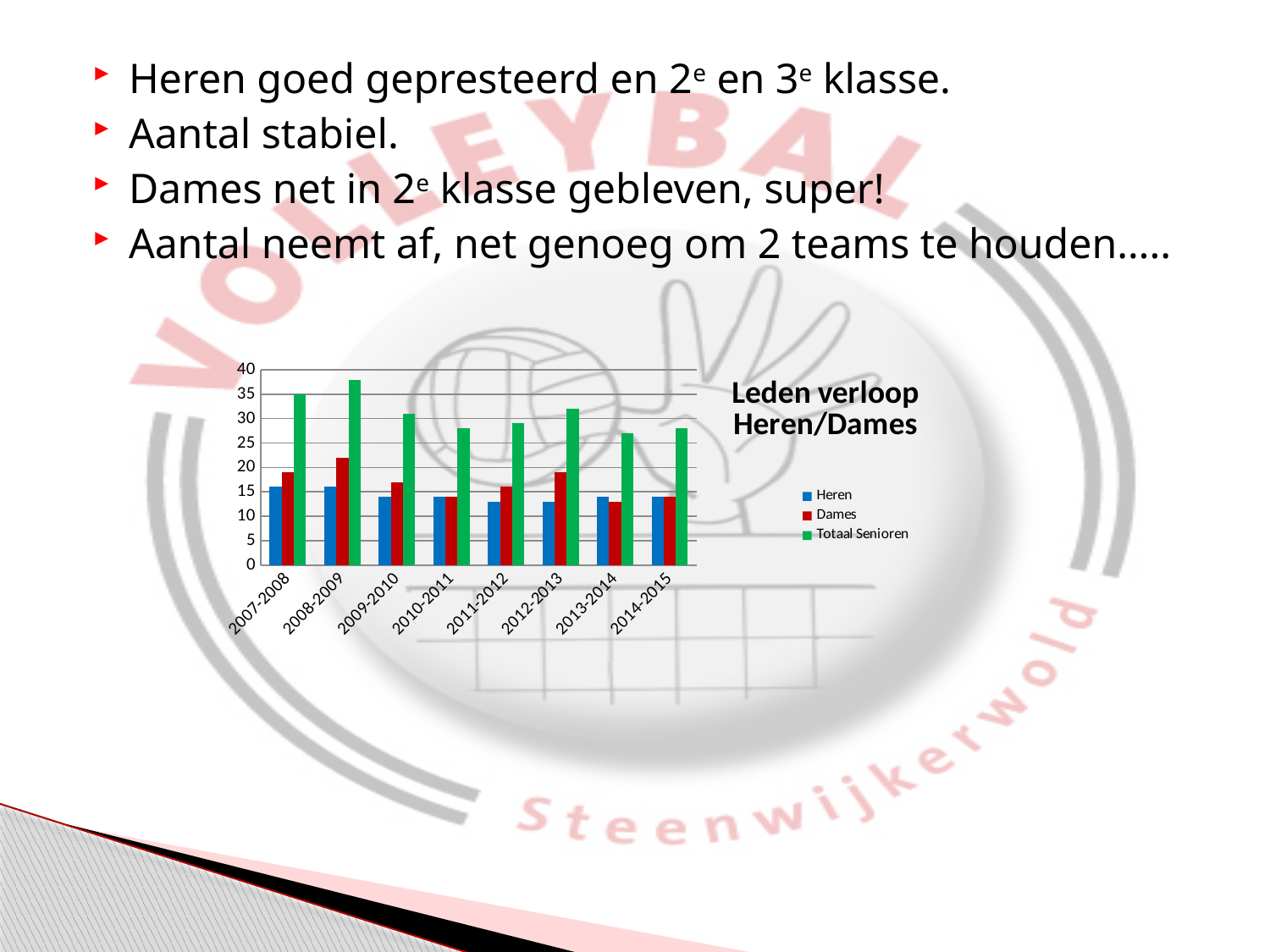
Which series is shown in green in the chart? Totaal Senioren Does the Totaal Senioren value generally rise or fall from 2007-2008 to 2014-2015? fall Is the Dames value for 2008-2009 greater or less than 20? greater In which season is the Dames value highest? 2008-2009 In 2008-2009, which is larger: the Heren value or the Dames value? Dames How many seasons are shown on the x axis of the chart? 8 What is the title of the chart? Leden verloop Heren/Dames Is the Totaal Senioren value for 2008-2009 greater or less than 35? greater What kind of chart is shown on the slide? bar chart Is the Heren value for 2011-2012 greater or less than 15? less How many series does the chart's legend list? 3 In which season is the Totaal Senioren value highest? 2008-2009